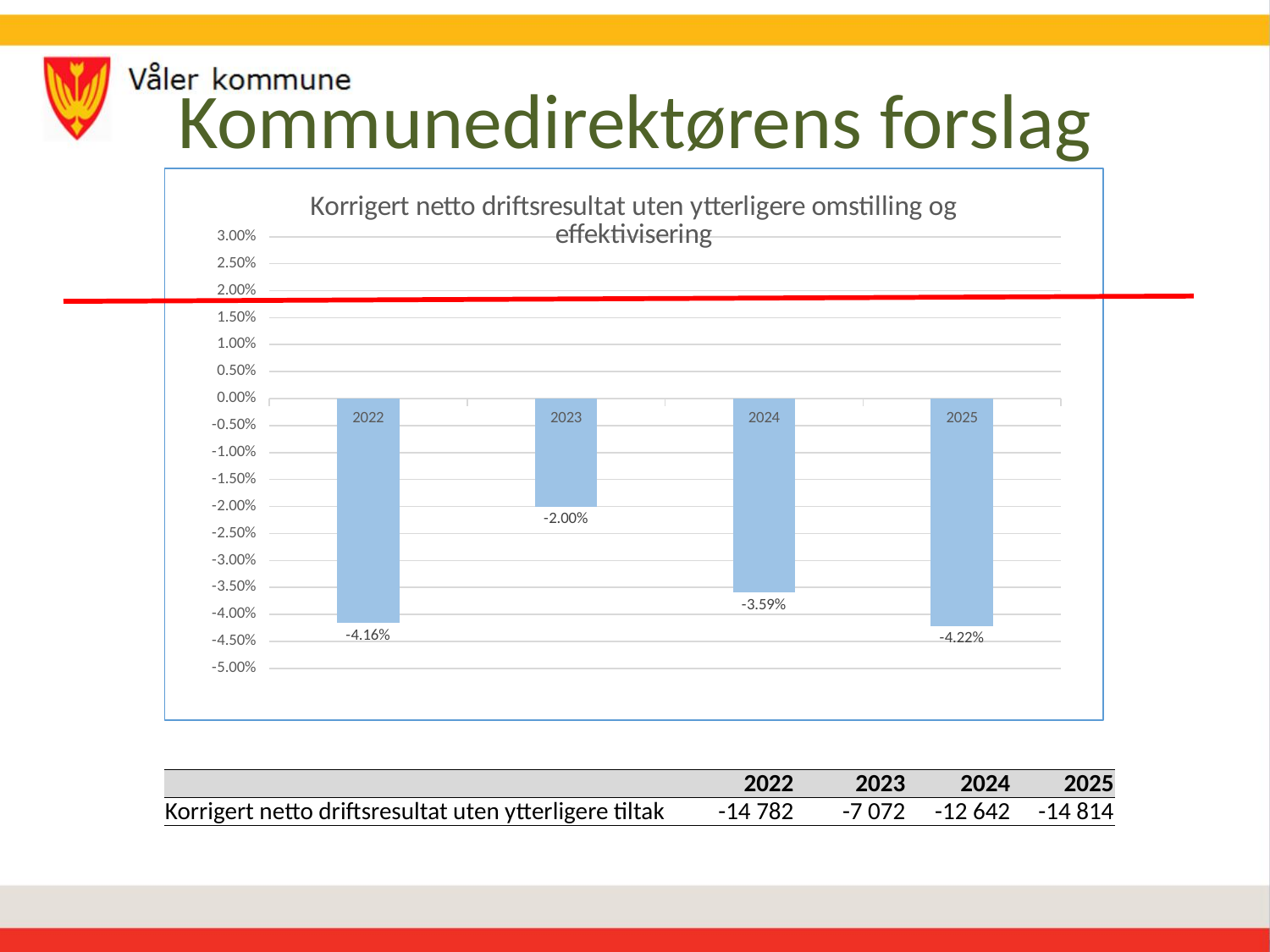
Which year has the larger value, 2023 or 2024? 2023 What kind of chart is shown on the slide? Bar chart How many years are shown in the chart? 4 What is the difference between the values for 2024 and 2025? 0.63 percentage points Which year has the lowest (most negative) value in the chart? 2025 What is the difference between the values for 2023 and 2022? 2.16 percentage points What is the value for 2025 in the chart? -4.22% What is the value for 2023 in the chart? -2.00% What is the value for 2022 in the chart? -4.16% What is the value for 2024 in the chart? -3.59% Is the value for 2024 greater or less than -3.00%? less Which year has the highest (least negative) value in the chart? 2023